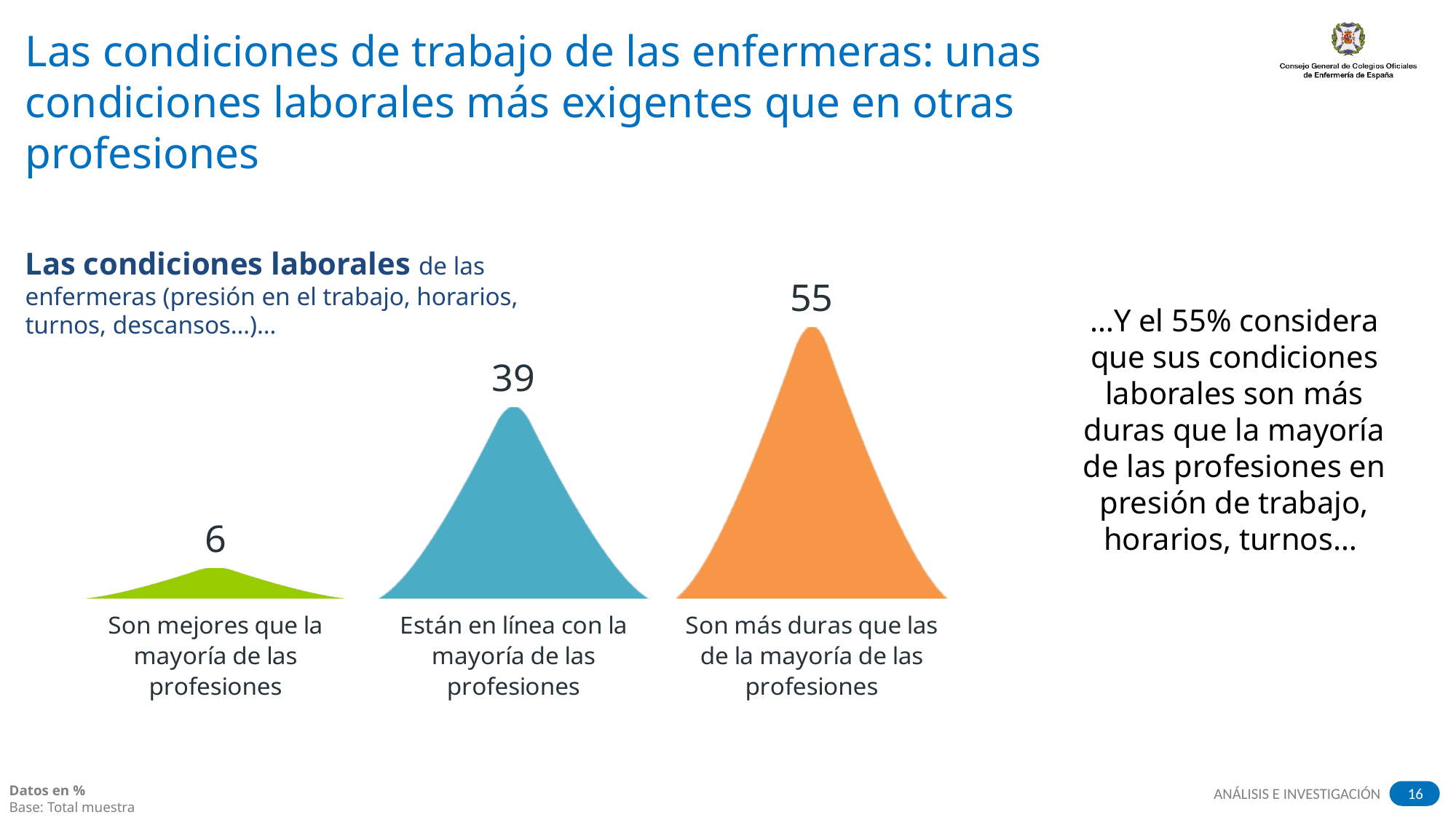
What is the value for "Están en línea con la mayoría de las profesiones"? 39 What is the difference between the values for "Son más duras que las de la mayoría de las profesiones" and "Están en línea con la mayoría de las profesiones"? 16 What is the difference between the values for "Están en línea con la mayoría de las profesiones" and "Son mejores que la mayoría de las profesiones"? 33 Which category has the lowest value? Son mejores que la mayoría de las profesiones In what unit are the chart's data expressed, according to the note at the bottom left? % Which is larger: the value for "Están en línea con la mayoría de las profesiones" or for "Son mejores que la mayoría de las profesiones"? Están en línea con la mayoría de las profesiones What is the value for "Son mejores que la mayoría de las profesiones"? 6 What is the value for "Son más duras que las de la mayoría de las profesiones"? 55 Which category has the highest value? Son más duras que las de la mayoría de las profesiones What colour is the shape for "Son más duras que las de la mayoría de las profesiones"? orange Do the values rise or fall from left to right across the categories? rise How many categories are shown in the chart? 3